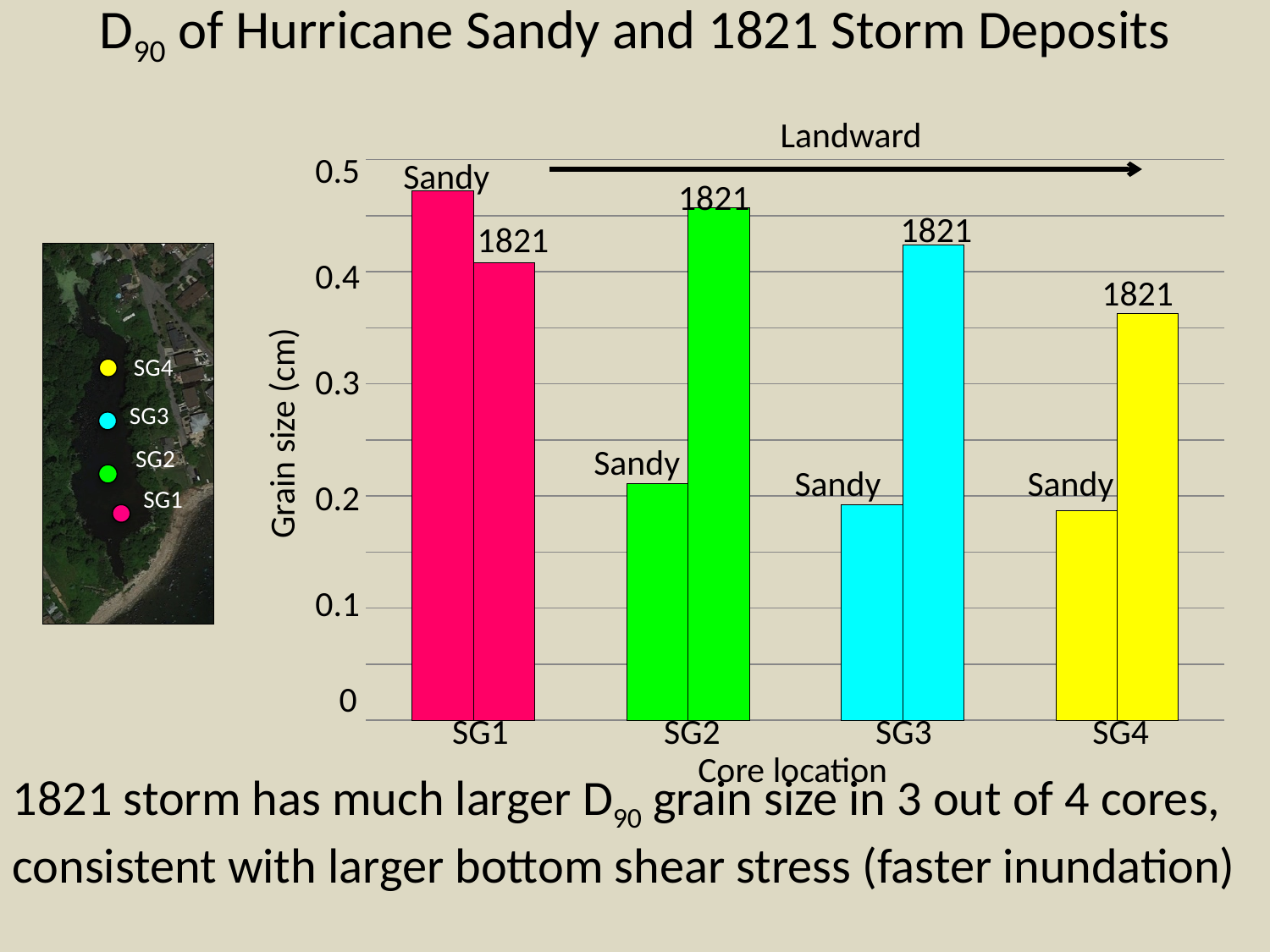
Which core location has the lowest 1821 value? SG4 At SG1, which is larger, the Sandy value or the 1821 value? Sandy What kind of chart is shown on the slide? bar chart Is the 1821 value for SG2 greater or less than 0.4? greater Is the 1821 value for SG4 greater or less than 0.4? less How many core locations are shown on the x axis of the chart? 4 Is the Sandy value for SG1 greater or less than 0.4? greater Which core location has the highest Sandy value? SG1 What is the x-axis title of the chart? Core location At SG3, which is larger, the Sandy value or the 1821 value? 1821 What is the y-axis title of the chart? Grain size (cm)